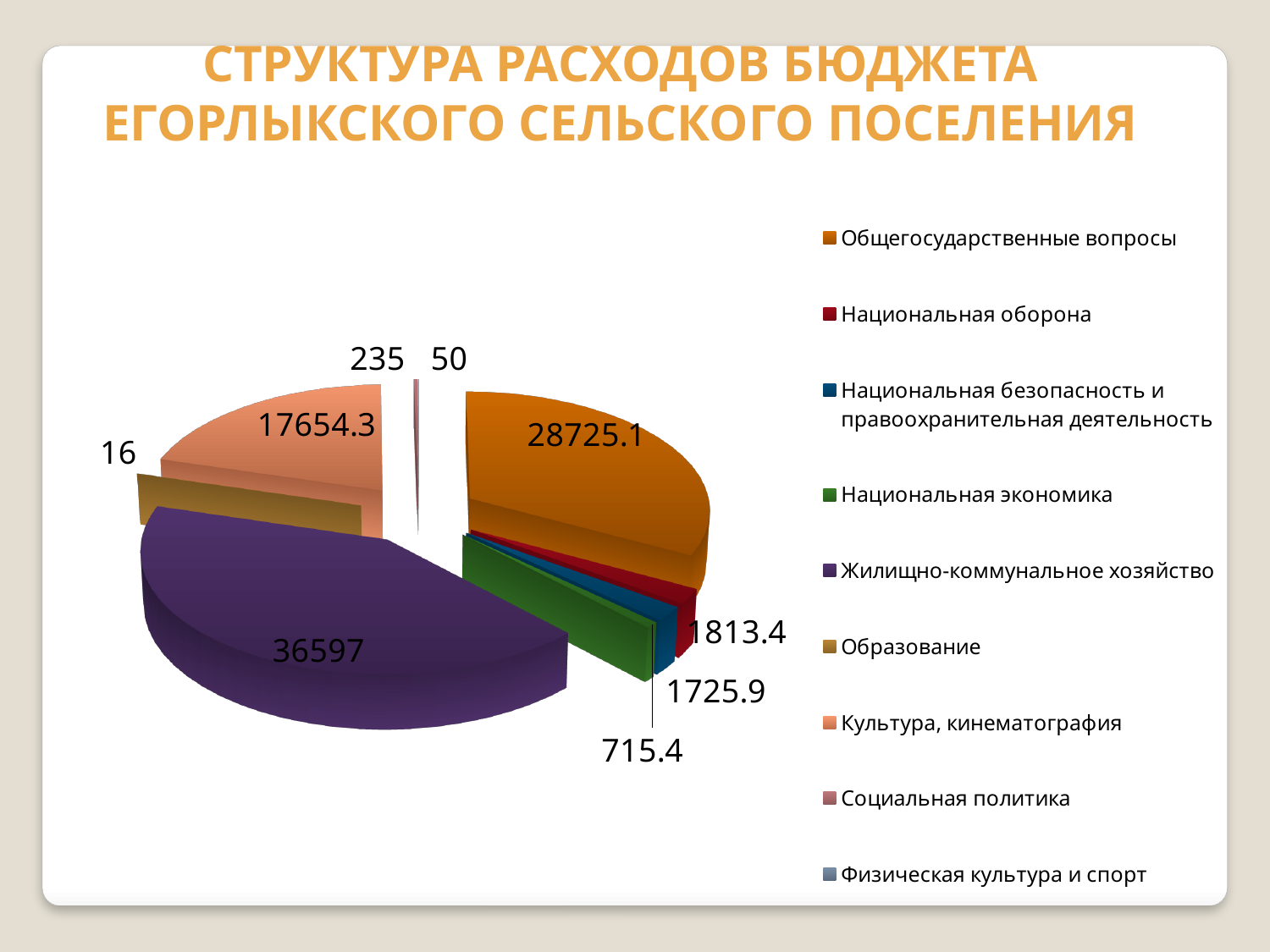
What is the value for Общегосударственные вопросы? 28725.1 How many categories does the pie chart's legend list? 9 Which category has the largest slice of the pie? Жилищно-коммунальное хозяйство What is the value for Образование? 16 What is the value for Культура, кинематография? 17654.3 Which category has the smallest value? Образование What is the title of the slide containing the chart? СТРУКТУРА РАСХОДОВ БЮДЖЕТА ЕГОРЛЫКСКОГО СЕЛЬСКОГО ПОСЕЛЕНИЯ What kind of chart is shown on the slide? Pie chart Which is larger, the value for Национальная оборона or the value for Национальная безопасность и правоохранительная деятельность? Национальная оборона What is the value for Национальная оборона? 1813.4 What is the difference between the values for Жилищно-коммунальное хозяйство and Общегосударственные вопросы? 7871.9 What is the value for Жилищно-коммунальное хозяйство? 36597